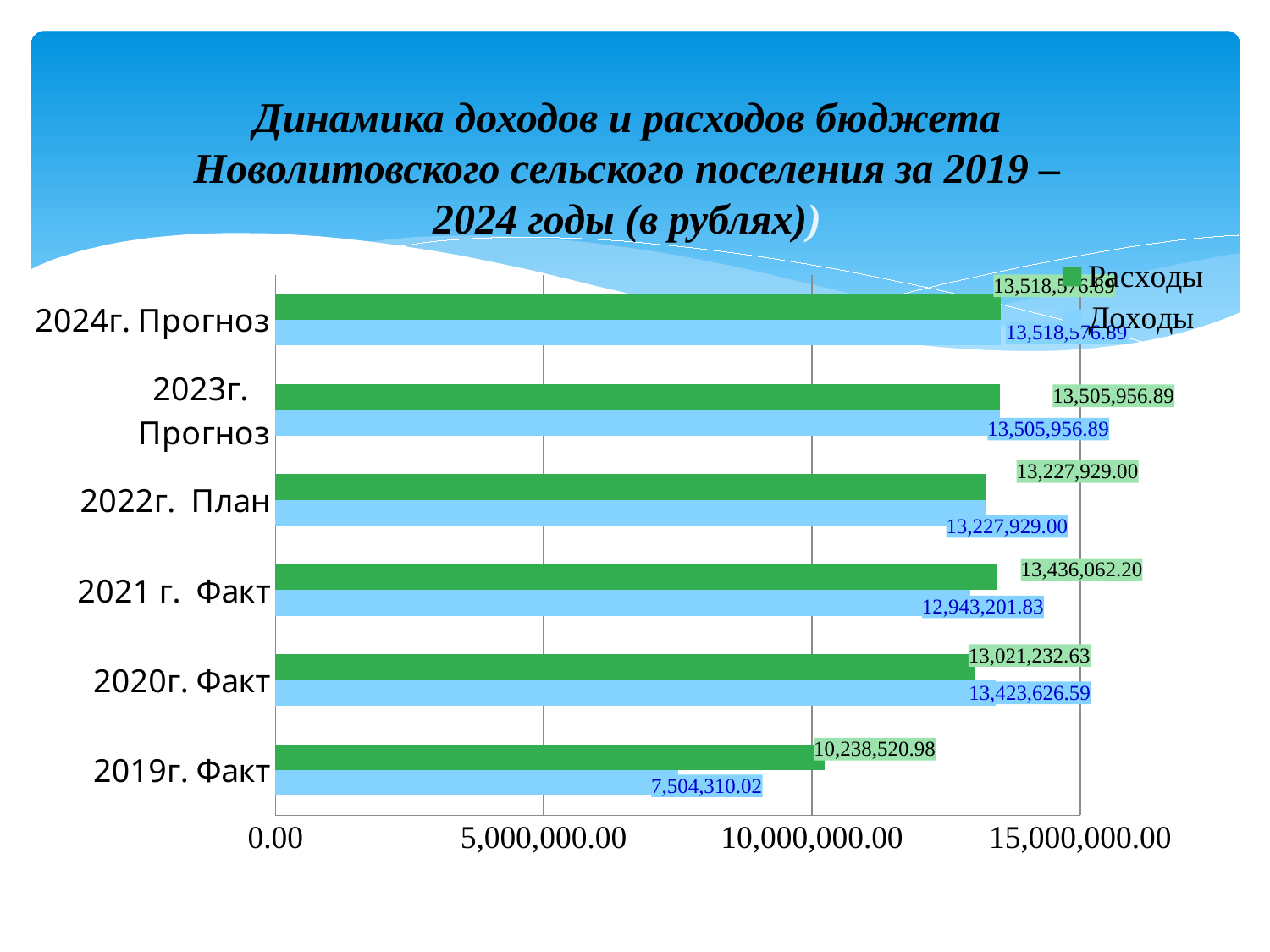
For 2020г. Факт, which is larger: Доходы or Расходы? Доходы What is the difference between Расходы and Доходы for 2019г. Факт? 2,734,210.96 What is the difference between Расходы and Доходы for 2021 г. Факт? 492,860.37 Which category has the lowest value of Доходы? 2019г. Факт What is the value of Доходы for 2019г. Факт? 7,504,310.02 What is the value of Доходы for 2020г. Факт? 13,423,626.59 What is the value of Расходы for 2021 г. Факт? 13,436,062.20 What is the value of Доходы for 2022г. План? 13,227,929.00 How many series does the legend list? 2 What is the value of Расходы for 2019г. Факт? 10,238,520.98 How many categories are shown on the chart? 6 Is the value of Доходы for 2019г. Факт greater or less than 10,000,000.00? less